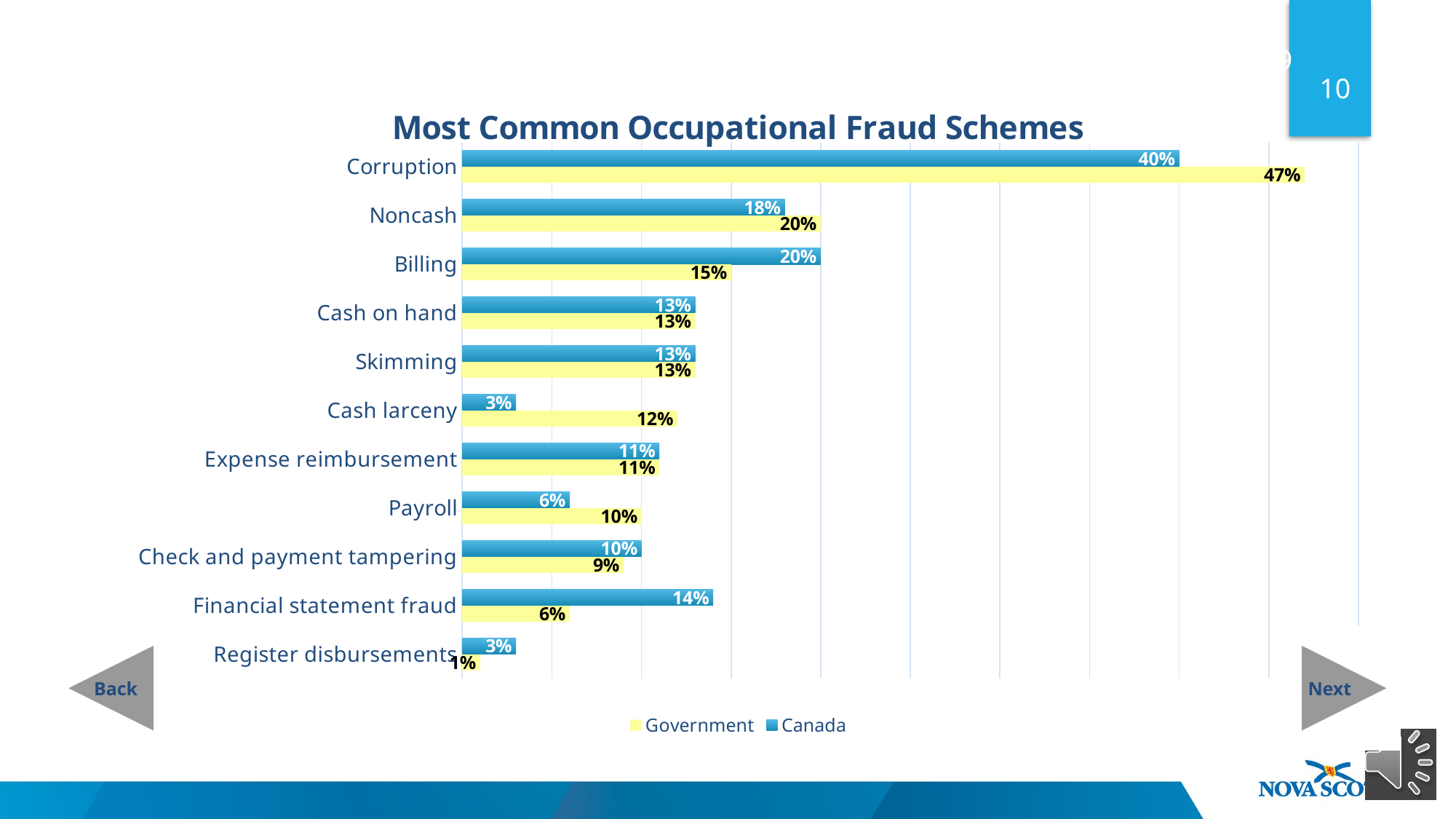
How many series does the legend list? 2 What is the difference between the Government and Canada values for Corruption? 7% What is the Government value for Financial statement fraud? 6% What is the Government value for Corruption? 47% What kind of chart is shown on the slide? Bar chart Which category has the highest Canada value? Corruption Which is larger for Payroll, the Government value or the Canada value? Government How many categories are shown on the chart? 11 What is the difference between the Government and Canada values for Cash larceny? 9% Which category has the lowest Government value? Register disbursements What is the Canada value for Cash larceny? 3% What is the Canada value for Billing? 20%